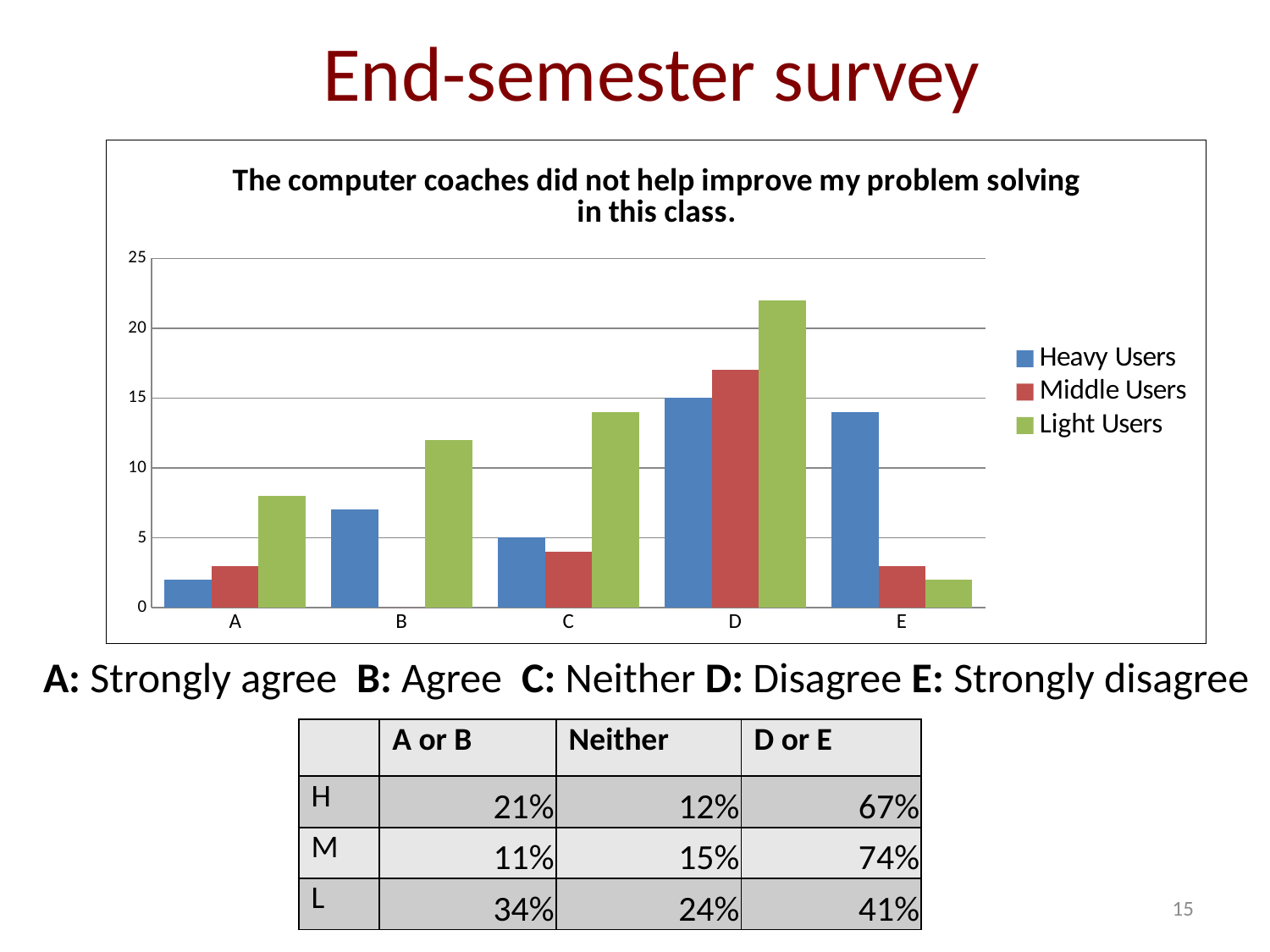
Is the value for Heavy Users at A greater or less than 5? less At category A, which is larger: Light Users or Heavy Users? Light Users For which category is the Light Users bar highest? D What colour are the Light Users bars? green Is the value for Light Users at D greater or less than 20? greater At category E, which is larger: Heavy Users or Middle Users? Heavy Users How many series does the legend list? 3 Is the value for Middle Users at D greater or less than 15? greater How many categories are shown on the x axis? 5 What kind of chart is shown on the slide? bar chart For which category is the Heavy Users bar lowest? A